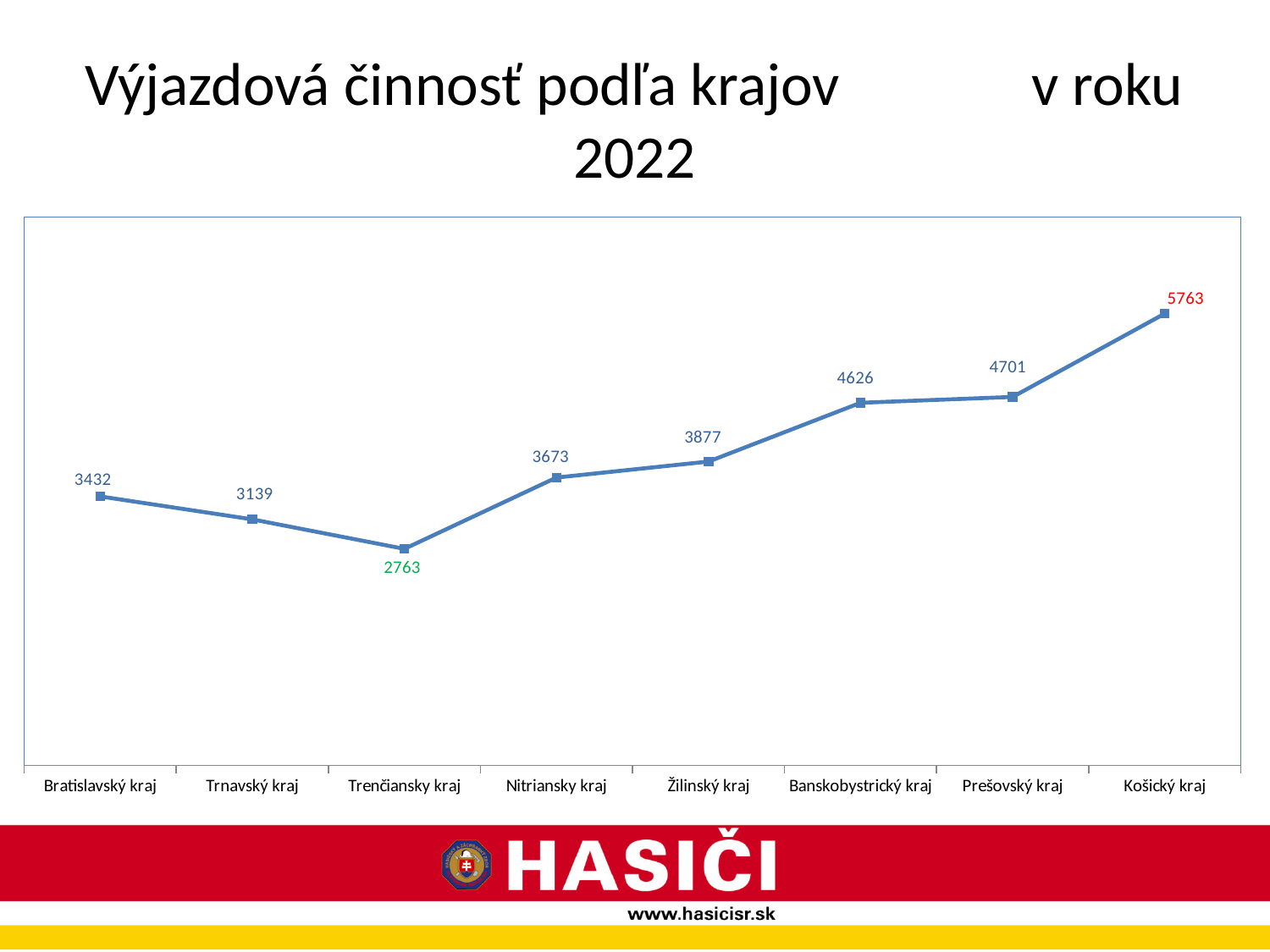
What is the difference between the values for Bratislavský kraj and Trnavský kraj? 293 What is the value for Banskobystrický kraj? 4626 What is the value for Košický kraj? 5763 Which region has the highest value? Košický kraj How many regions are plotted on the chart? 8 What is the difference between the values for Košický kraj and Prešovský kraj? 1062 Which is larger, the value for Žilinský kraj or the value for Nitriansky kraj? Žilinský kraj What is the value for Trenčiansky kraj? 2763 What kind of chart is shown on the slide? Line chart Which region has the lowest value? Trenčiansky kraj Do the values rise or fall from Trenčiansky kraj to Košický kraj? Rise What is the value for Nitriansky kraj? 3673